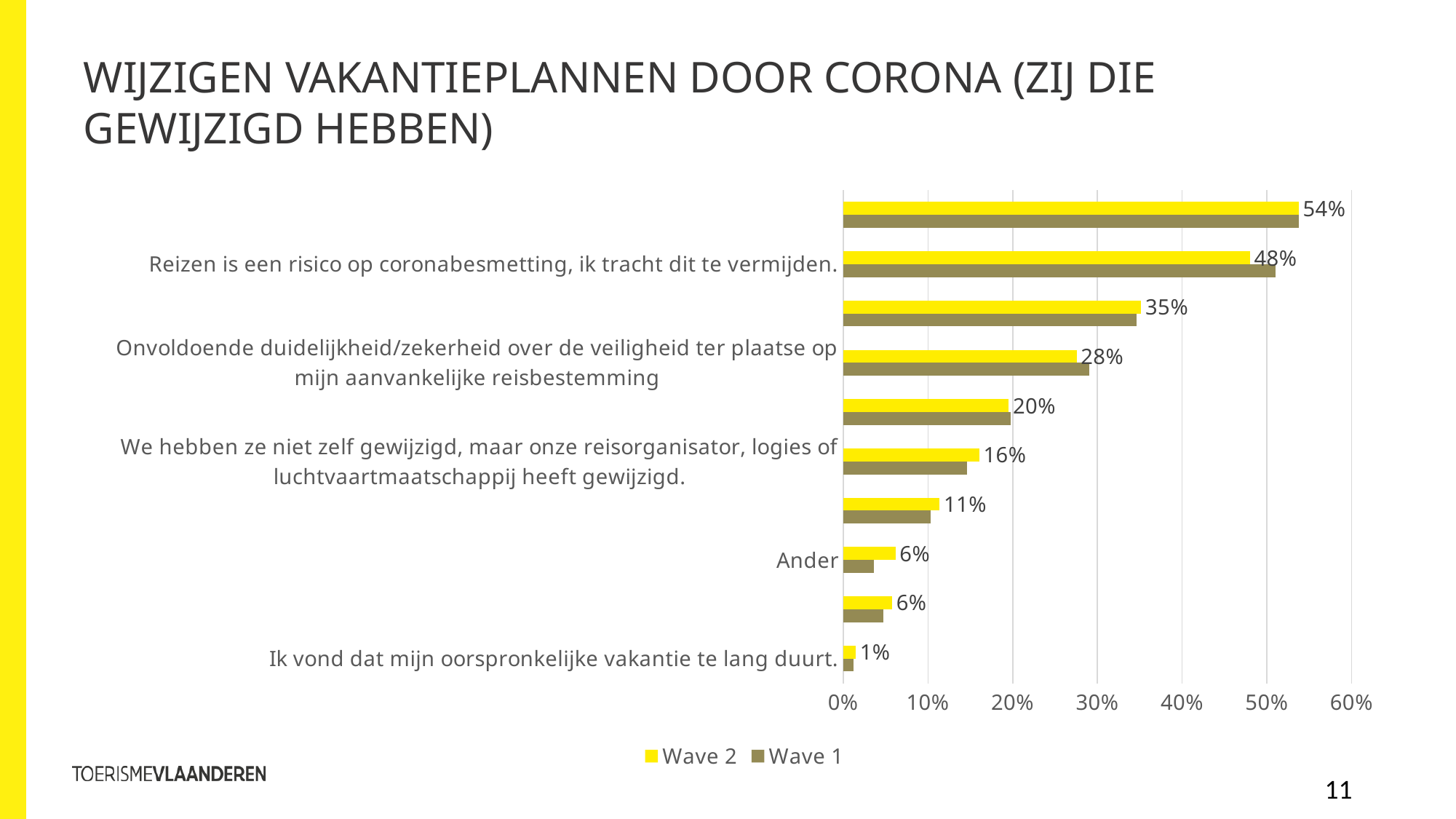
What is the highest Wave 2 value shown in the chart? 54% Is the Wave 1 value for "Reizen is een risico op coronabesmetting, ik tracht dit te vermijden." greater or less than 40%? greater What is the Wave 2 value for "Ik vond dat mijn oorspronkelijke vakantie te lang duurt."? 1% What is the difference between the Wave 2 values for "Reizen is een risico op coronabesmetting, ik tracht dit te vermijden." and "Ander"? 42 percentage points What are the two series named in the legend? Wave 2 and Wave 1 How many categories (bar pairs) are plotted in the chart? 10 What is the Wave 2 value for "We hebben ze niet zelf gewijzigd, maar onze reisorganisator, logies of luchtvaartmaatschappij heeft gewijzigd."? 16% What is the Wave 2 value for "Ander"? 6% What is the Wave 2 value for "Onvoldoende duidelijkheid/zekerheid over de veiligheid ter plaatse op mijn aanvankelijke reisbestemming"? 28% What kind of chart is shown on the slide? Bar chart How many series does the legend list? 2 What is the Wave 2 value for "Reizen is een risico op coronabesmetting, ik tracht dit te vermijden."? 48%